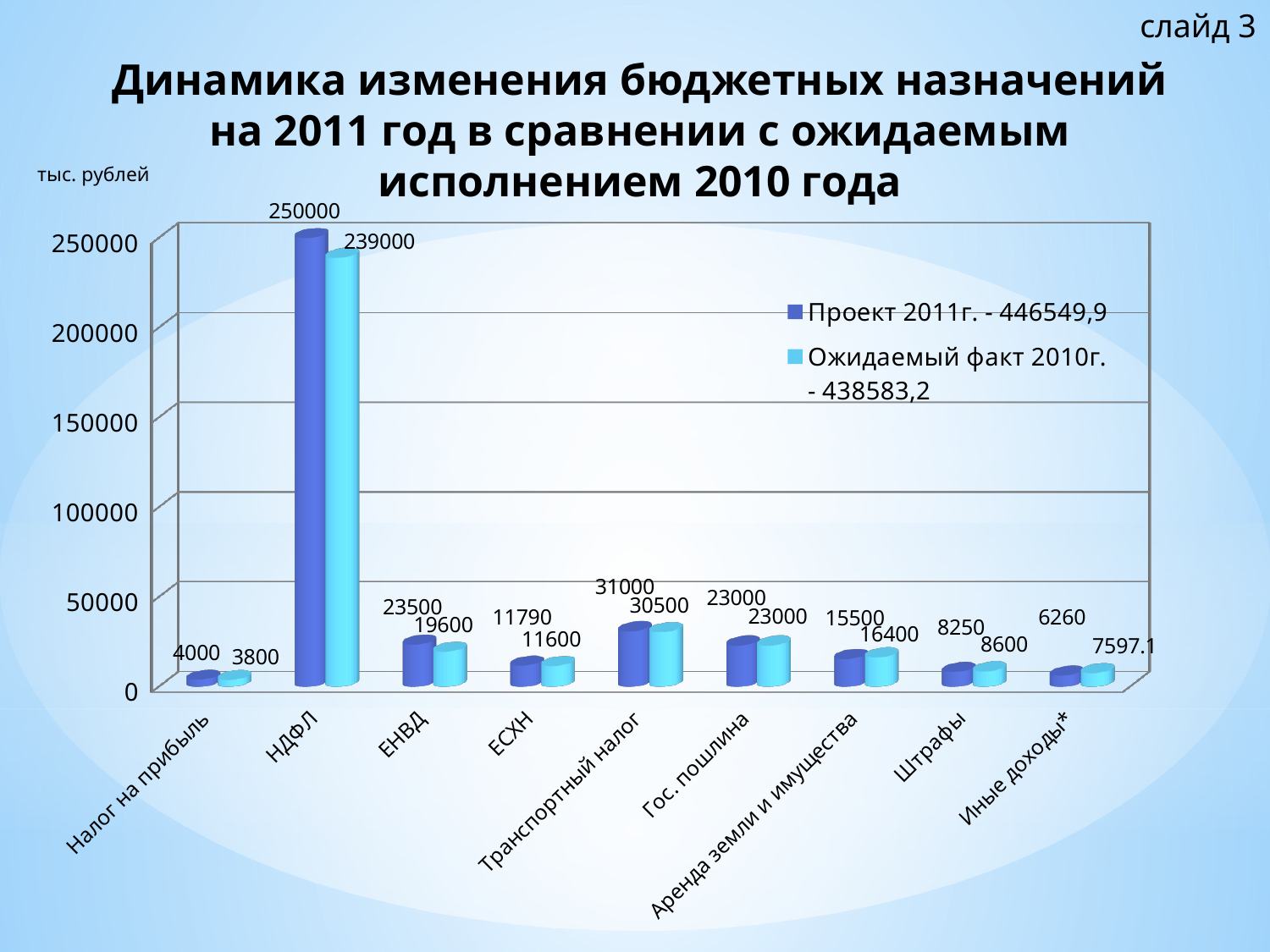
What is the difference between the Проект 2011г. and Ожидаемый факт 2010г. values for ЕНВД? 3900 How many series does the legend list? 2 How many categories are shown on the x axis? 9 What is the difference between the Проект 2011г. and Ожидаемый факт 2010г. values for НДФЛ? 11000 What kind of chart is shown on the slide? bar chart What is the value for Иные доходы* in the Ожидаемый факт 2010г. series? 7597.1 For Аренда земли и имущества, which series has the larger value: Проект 2011г. or Ожидаемый факт 2010г.? Ожидаемый факт 2010г. What is the value for НДФЛ in the Проект 2011г. series? 250000 Which category has the lowest value in the Ожидаемый факт 2010г. series? Налог на прибыль Which category has the highest value in the Проект 2011г. series? НДФЛ What is the value for ЕСХН in the Проект 2011г. series? 11790 Is the Проект 2011г. value for Транспортный налог greater or less than 50000? less